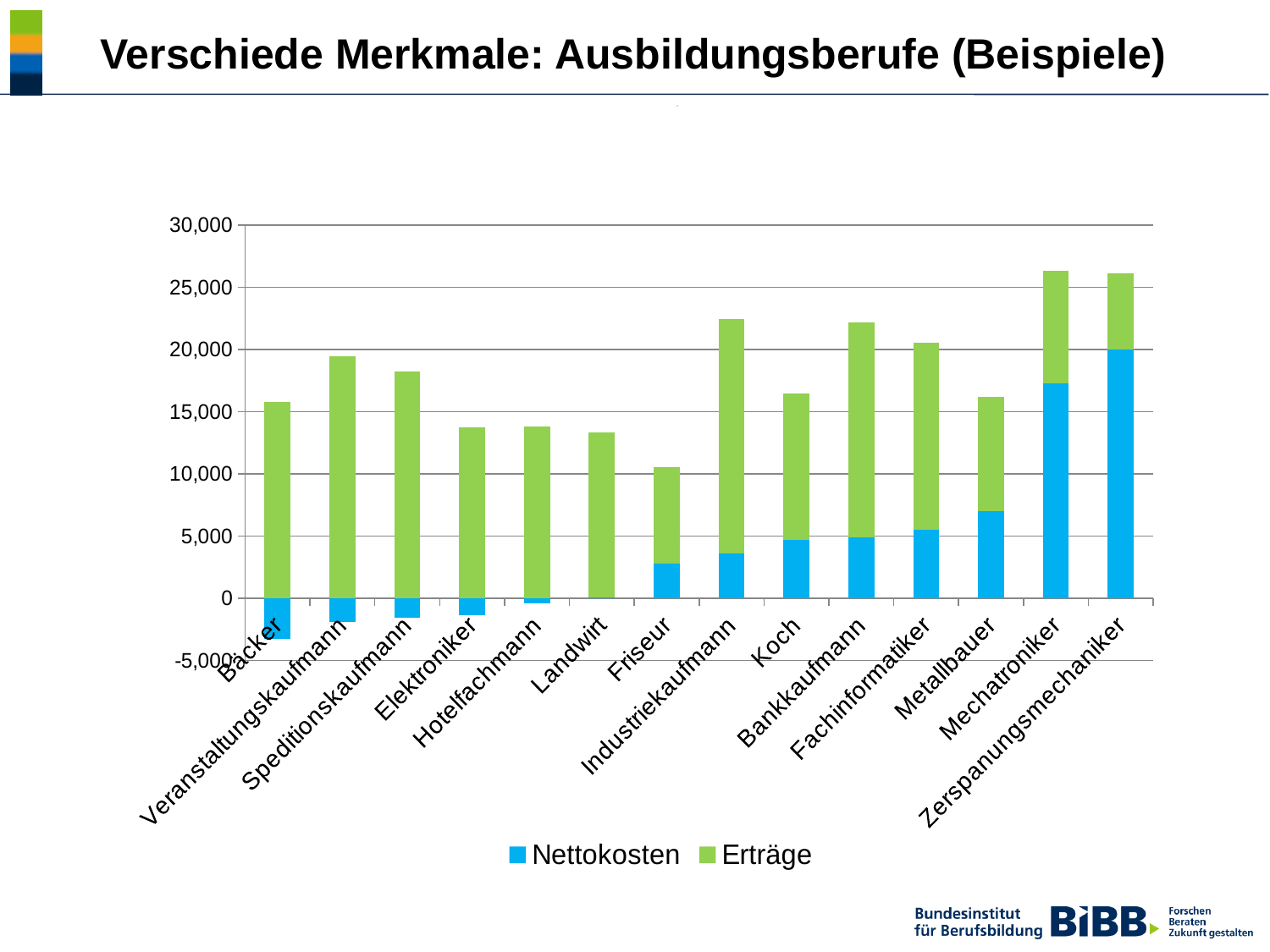
What kind of chart is shown on the slide? Stacked bar chart Which series is shown in blue in the chart? Nettokosten How many series does the chart legend list? 2 Is the Nettokosten value for Metallbauer greater or less than 5,000? greater Is the top of the stacked bar for Industriekaufmann greater or less than 20,000? greater Which series is shown in green in the chart? Erträge Which occupation has the highest Nettokosten value in the chart? Zerspanungsmechaniker Is the top of the stacked bar for Landwirt greater or less than 15,000? less How many occupations (categories) are shown on the x axis of the chart? 14 Which has the taller stacked bar, Industriekaufmann or Koch? Industriekaufmann Which occupation has the lowest (most negative) Nettokosten value in the chart? Bäcker